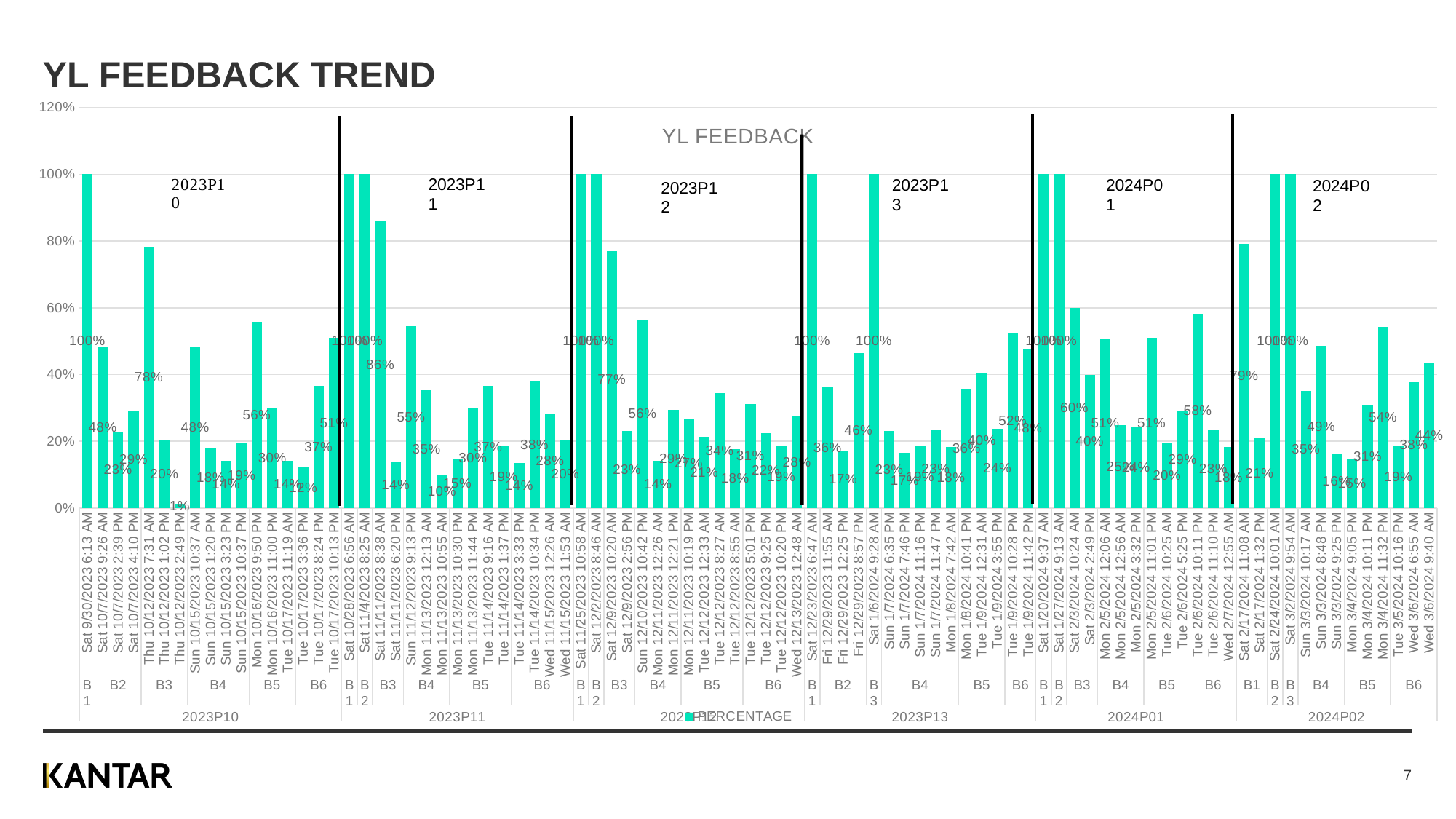
How many period groups (e.g. 2023P10) are shown along the x axis? 6 Which date/time has the lowest value in the chart? Thu 10/12/2023 2:49 PM What is the difference between the values for Sat 11/11/2023 8:38 AM and Sun 11/12/2023 9:13 PM? 31% What kind of chart is shown on the slide? bar chart What is the highest value shown in the chart? 100% How many series does the legend list? 1 What is the value for Sat 2/17/2024 11:08 AM? 79% What is the value for Sat 11/11/2023 8:38 AM? 86% What is the value for Thu 10/12/2023 7:31 AM? 78% What is the title of the chart? YL FEEDBACK What is the value for Sat 12/9/2023 10:20 AM? 77% Which is larger, the value for Sat 11/11/2023 8:38 AM or the value for Thu 10/12/2023 7:31 AM? Sat 11/11/2023 8:38 AM